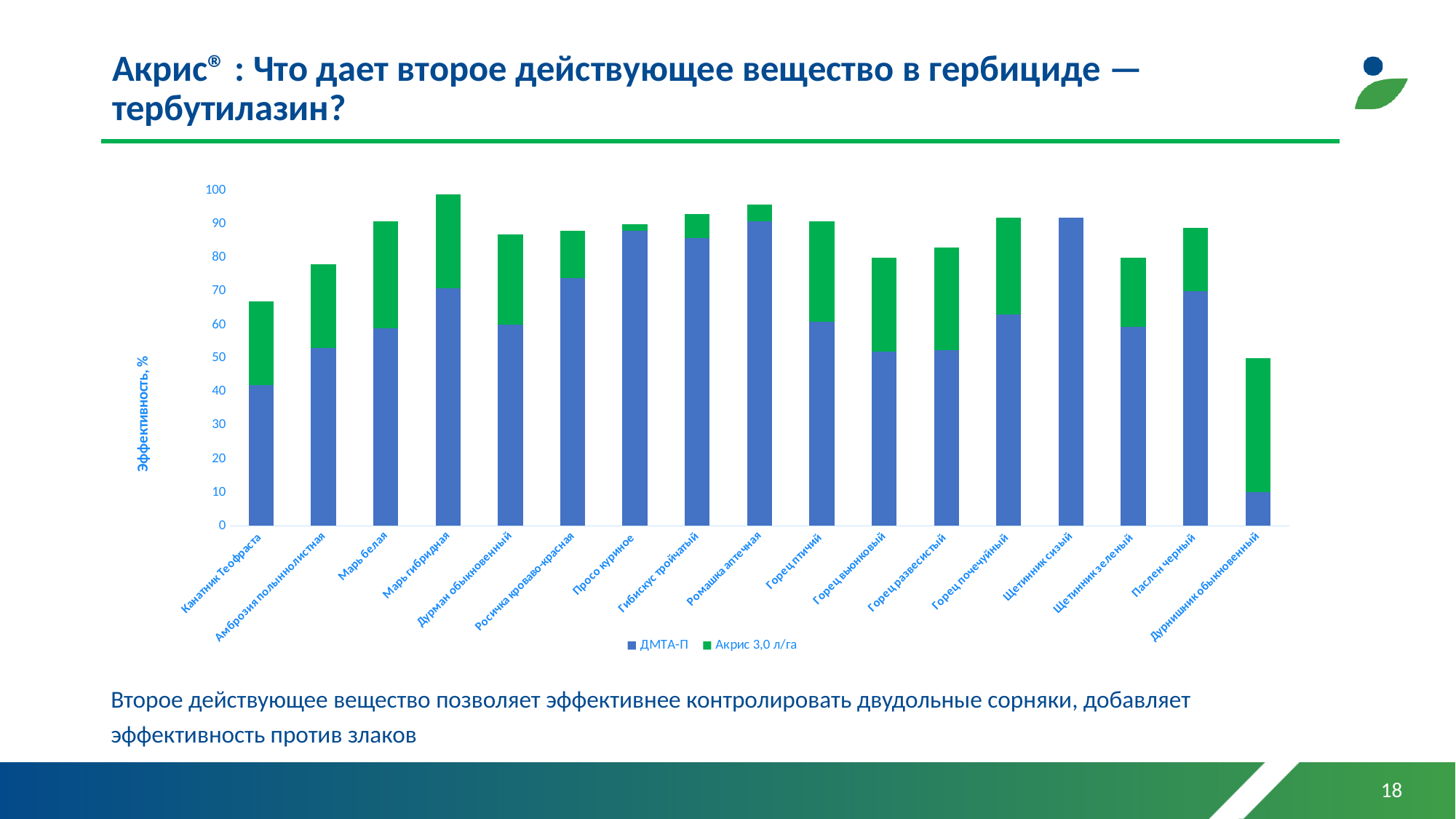
Is the ДМТА-П value for Ромашка аптечная greater or less than 80? greater Is the total bar height for Марь гибридная greater or less than 90? greater What kind of chart is shown on the slide? Stacked bar chart What are the two series named in the chart legend? ДМТА-П and Акрис 3,0 л/га Is the ДМТА-П value for Канатник Теофраста greater or less than 50? less How many series does the chart legend list? 2 Which category has the lowest ДМТА-П value in the chart? Дурнишник обыкновенный How many weed categories are shown along the x axis of the chart? 17 What is the label of the y axis of the chart? Эффективность, % Which has the larger total bar height: Канатник Теофраста or Амброзия полыннолистная? Амброзия полыннолистная Which category has the lowest total bar height in the chart? Дурнишник обыкновенный